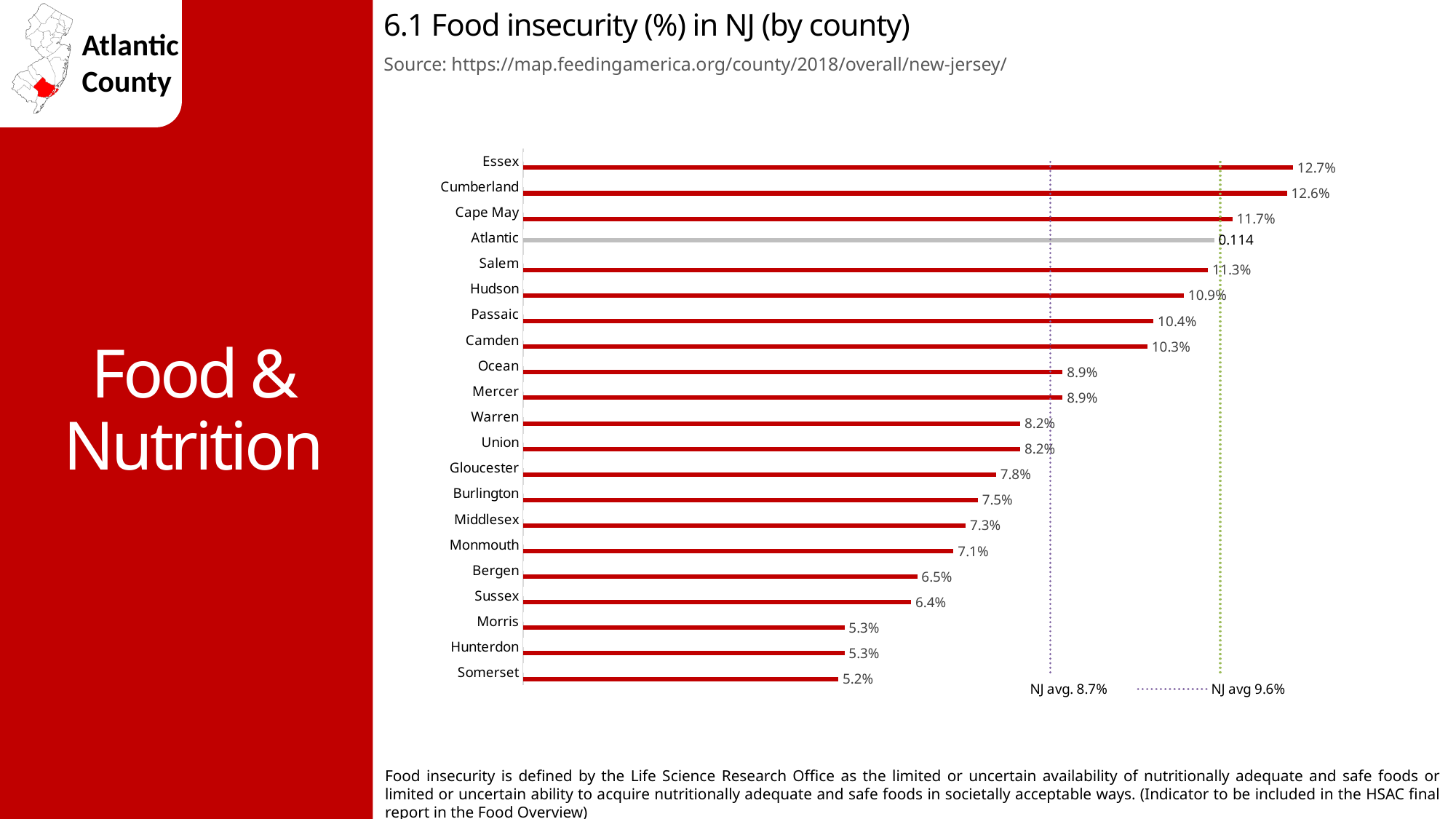
Which county has the highest food insecurity percentage? Essex How many counties are plotted in the chart? 21 What is the food insecurity value shown for Camden? 10.3% What type of chart is shown on the slide? bar chart What is the difference between the values for Cumberland and Cape May? 0.9 percentage points What two NJ average reference values are marked by the dotted lines? 8.7% and 9.6% What value label is shown for Atlantic county? 0.114 Do the values rise or fall going from the top county to the bottom county? fall What is the food insecurity value shown for Bergen? 6.5% What is the difference between the values for Essex and Somerset? 7.5 percentage points Which county has a higher value, Hudson or Passaic? Hudson Which county has the lowest food insecurity percentage? Somerset